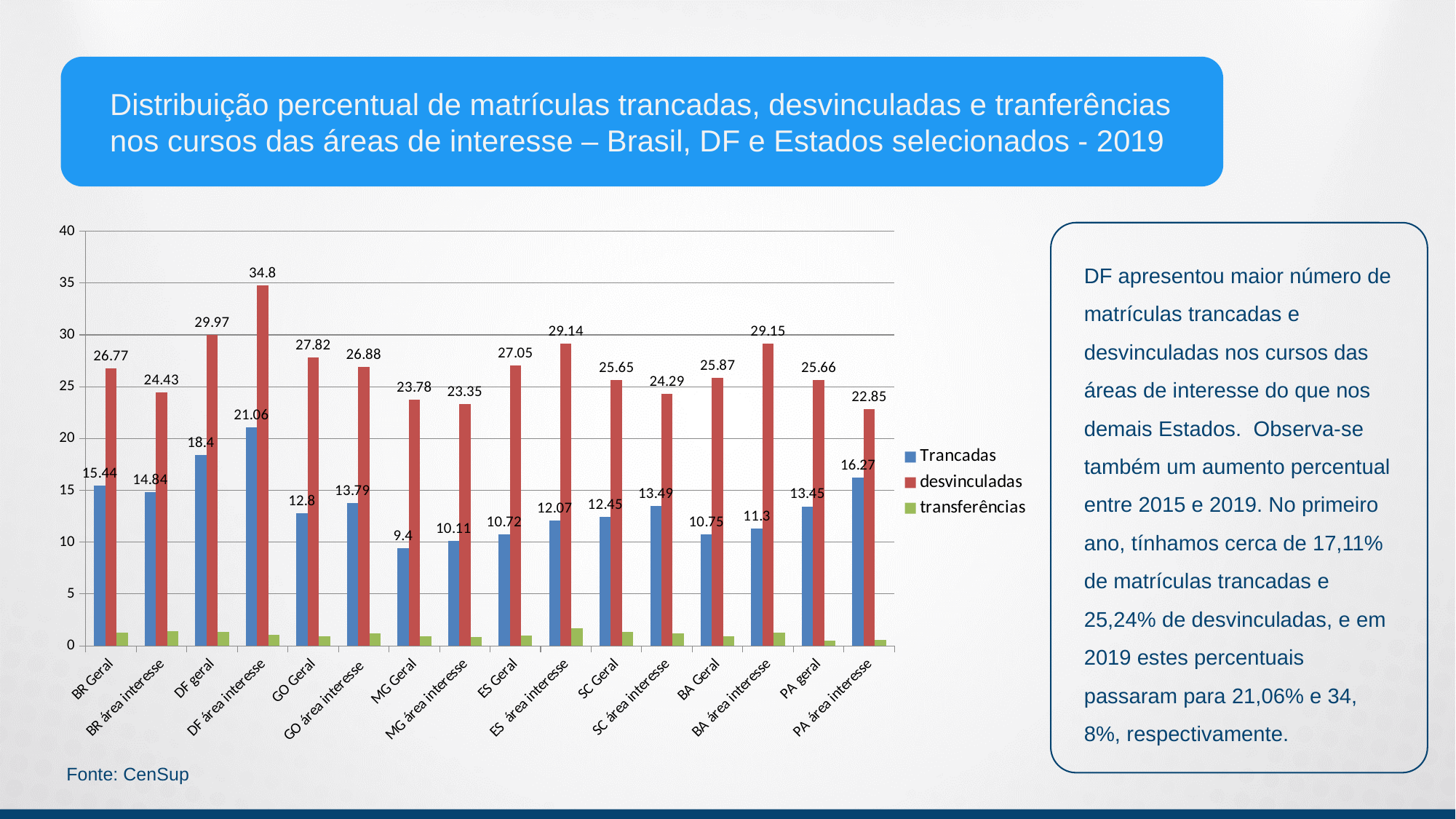
Which category has the highest desvinculadas value? DF área interesse How many series does the legend list? 3 What kind of chart is shown on the slide? bar chart Which category has the lowest Trancadas value? MG Geral Is the transferências value for BR Geral greater or less than 5? less What is the Trancadas value for MG Geral? 9.4 What is the difference between the desvinculadas and Trancadas values for DF área interesse? 13.74 What is the desvinculadas value for GO Geral? 27.82 What is the Trancadas value for DF área interesse? 21.06 Which category has the lowest desvinculadas value? PA área interesse How many categories are shown on the x axis? 16 Which is larger, the Trancadas value for DF geral or for PA área interesse? DF geral